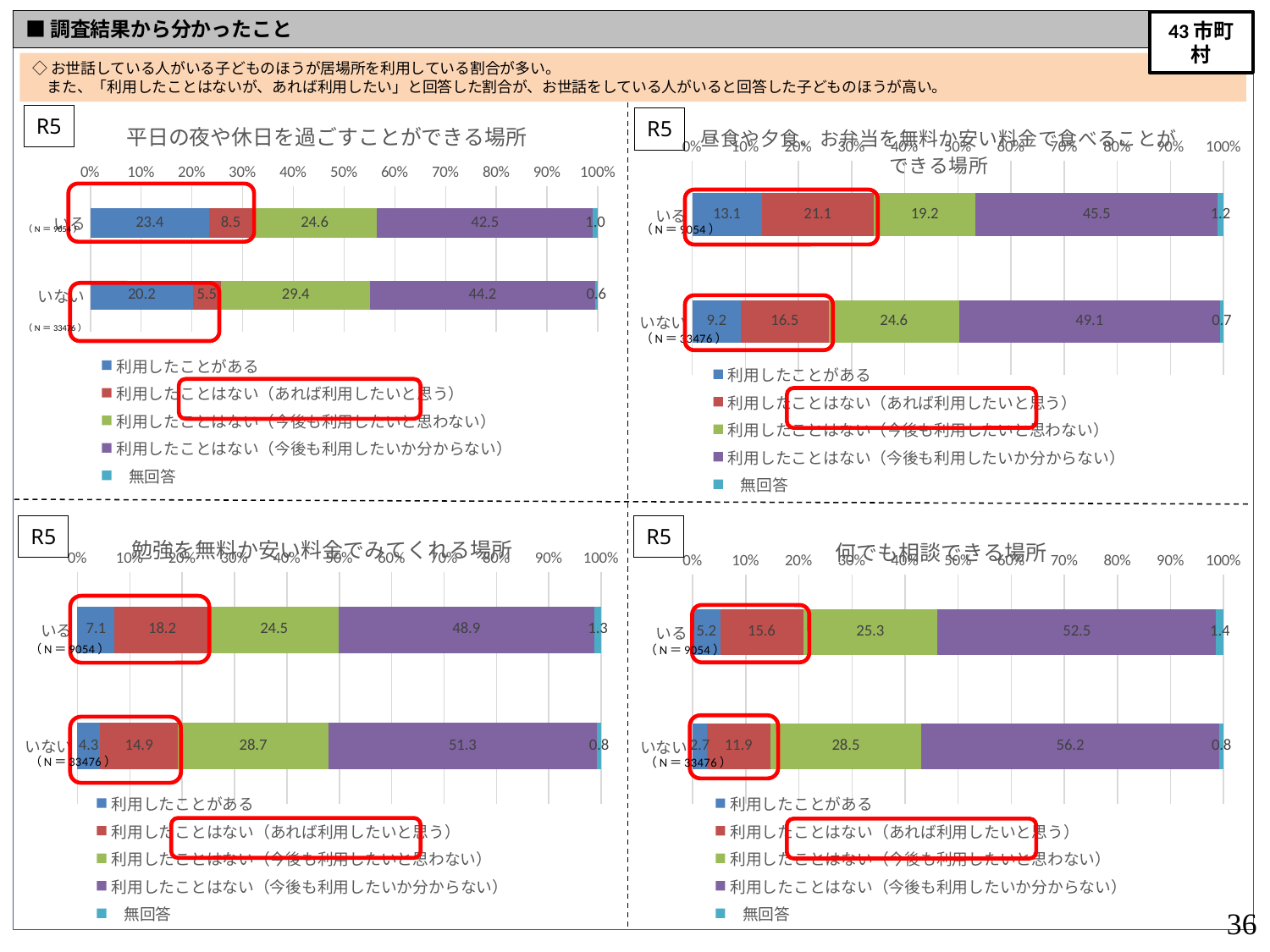
In the bottom-left chart titled 勉強を無料か安い料金でみてくれる場所, which category has the higher value for 利用したことはない（あれば利用したいと思う）, いる or いない? いる In the top-right chart titled 昼食や夕食、お弁当を無料か安い料金で食べることができる場所, what is the difference between the 利用したことがある values for いる and いない? 3.9 How many series does the legend list in the top-left chart titled 平日の夜や休日を過ごすことができる場所? 5 In the bottom-right chart titled 何でも相談できる場所, what is the value of 利用したことがある for the いない category? 2.7 In the top-right chart titled 昼食や夕食、お弁当を無料か安い料金で食べることができる場所, what is the value of 利用したことはない（あれば利用したいと思う） for the いる category? 21.1 How many categories are shown on the vertical axis of the top-right chart titled 昼食や夕食、お弁当を無料か安い料金で食べることができる場所? 2 What kind of chart is the bottom-left chart titled 勉強を無料か安い料金でみてくれる場所? Stacked bar chart In the top-left chart titled 平日の夜や休日を過ごすことができる場所, what is the value of 利用したことがある for the いる category? 23.4 In the bottom-right chart titled 何でも相談できる場所, which series has the largest value for the いる category? 利用したことはない（今後も利用したいか分からない） In the top-left chart titled 平日の夜や休日を過ごすことができる場所, what is the value of 利用したことはない（あれば利用したいと思う） for the いない category? 5.5 In the bottom-left chart titled 勉強を無料か安い料金でみてくれる場所, what is the value of 利用したことはない（今後も利用したいか分からない） for the いない category? 51.3 In the bottom-right chart titled 何でも相談できる場所, what is the difference between the 利用したことはない（あれば利用したいと思う） values for いる and いない? 3.7